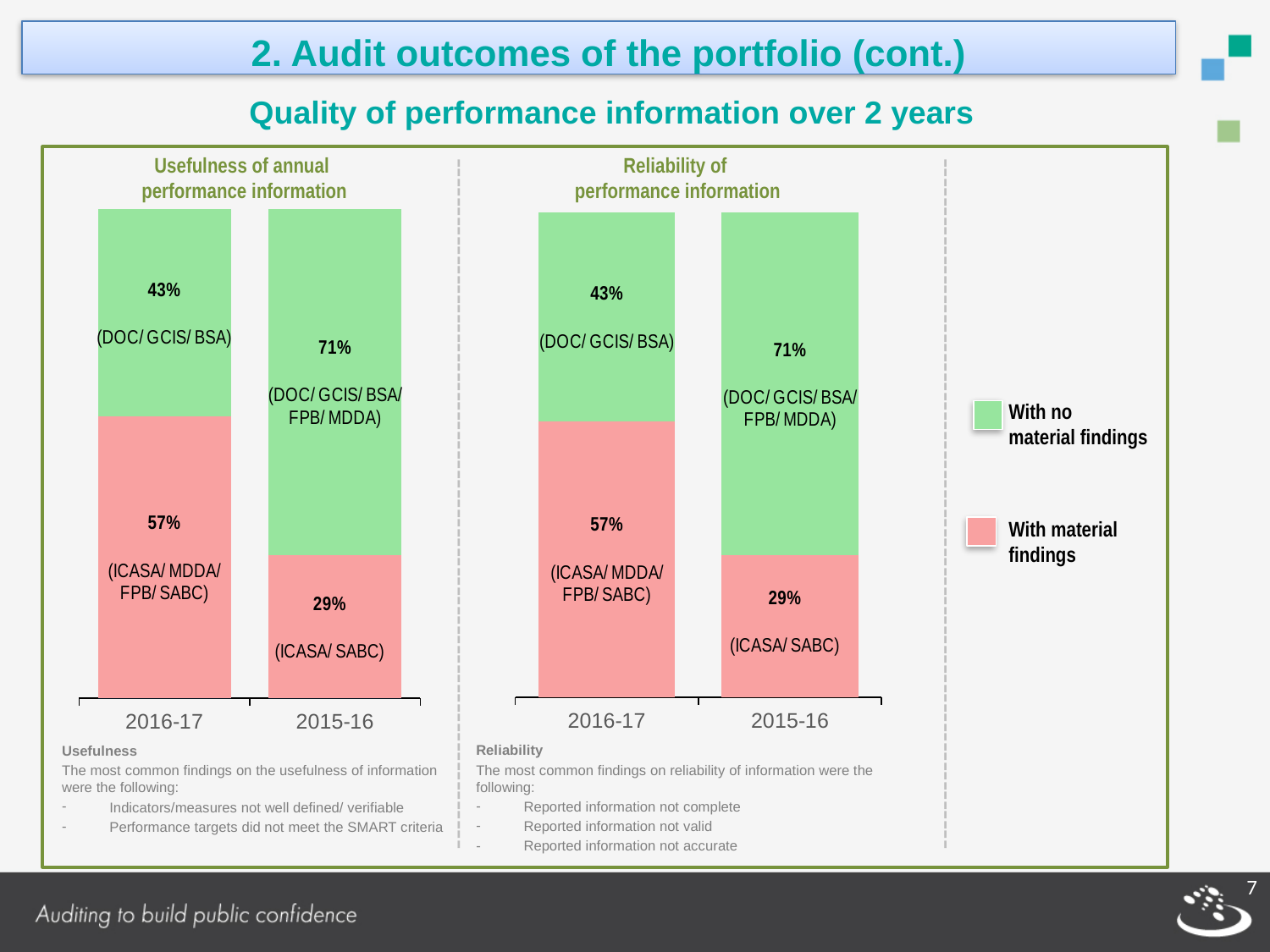
In the 'Usefulness of annual performance information' chart, which entities are listed in the 'With material findings' segment for 2015-16? ICASA/ SABC In the 'Usefulness of annual performance information' chart, what percentage had no material findings in 2015-16? 71% In the 'Reliability of performance information' chart, which year has the lower share with material findings? 2015-16 In the 'Usefulness of annual performance information' chart, which year has the higher share with no material findings? 2015-16 In the 'Reliability of performance information' chart, what percentage had no material findings in 2016-17? 43% In the 'Reliability of performance information' chart, what percentage had material findings in 2015-16? 29% How many series does the legend list for the charts? 2 What type of chart is the 'Reliability of performance information' chart? Stacked bar chart How many years are shown on the x axis of the 'Usefulness of annual performance information' chart? 2 In the 'Reliability of performance information' chart, is the 'With no material findings' share larger in 2016-17 or 2015-16? 2015-16 In the 'Usefulness of annual performance information' chart, what is the difference between the 'With material findings' share in 2016-17 and in 2015-16? 28% In the 'Usefulness of annual performance information' chart, what percentage had material findings in 2016-17? 57%